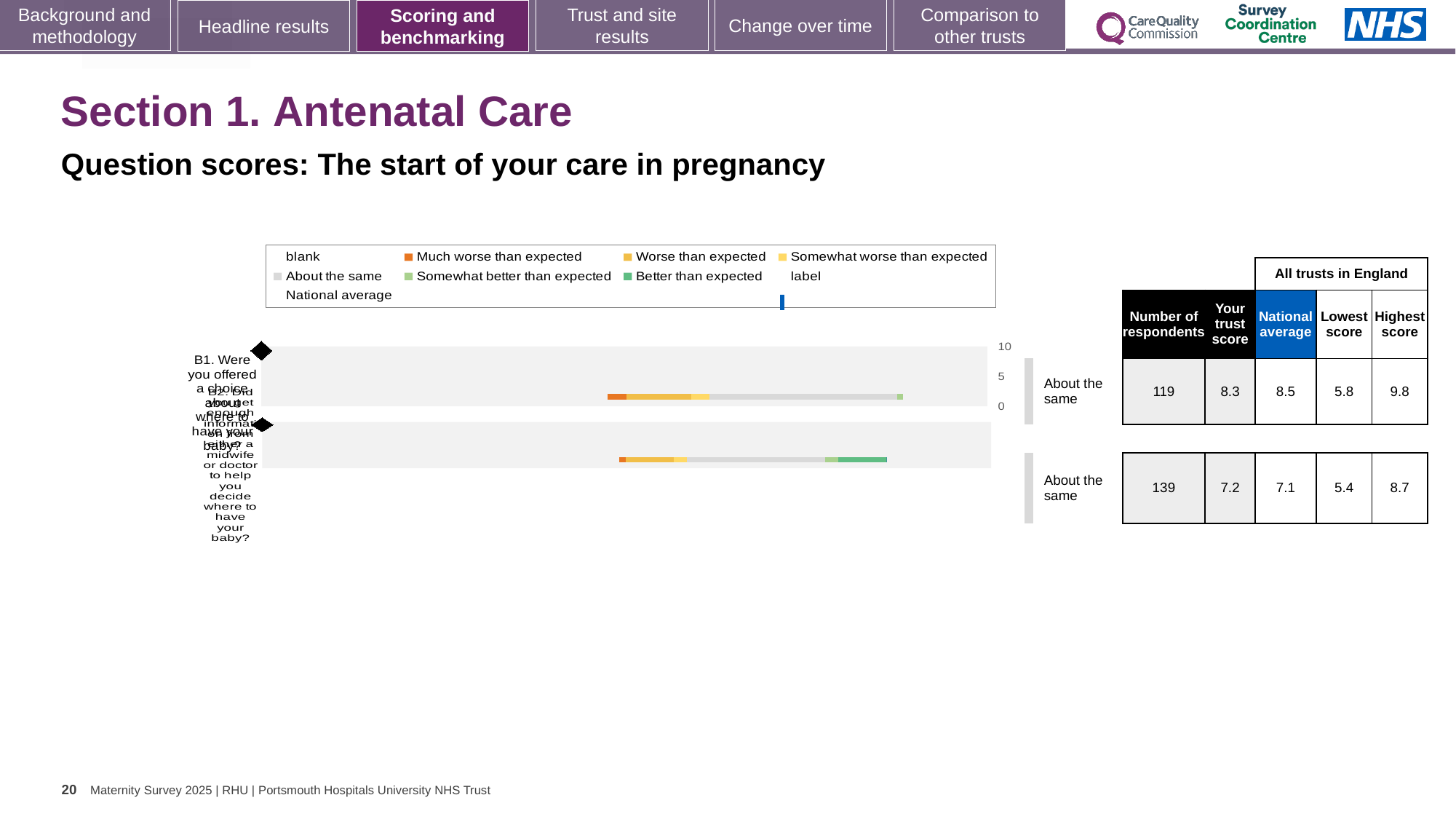
What is the highest score among all trusts in England for question B1? 9.8 What benchmark category is shown for question B1's trust score? About the same What is the difference between the trust score and the national average for question B2? 0.1 What is the difference between the highest and lowest scores for question B1? 4.0 What is the national average score for question B2? 7.1 What kind of chart is used to show the question scores? Bar chart What is the lowest score among all trusts in England for question B2? 5.4 How many respondents answered question B2? 139 How many respondents answered question B1? 119 What is the trust score for question B1 (Were you offered a choice about where to have your baby?)? 8.3 Which question has the higher trust score, B1 or B2? B1 How many questions are plotted in the chart? 2